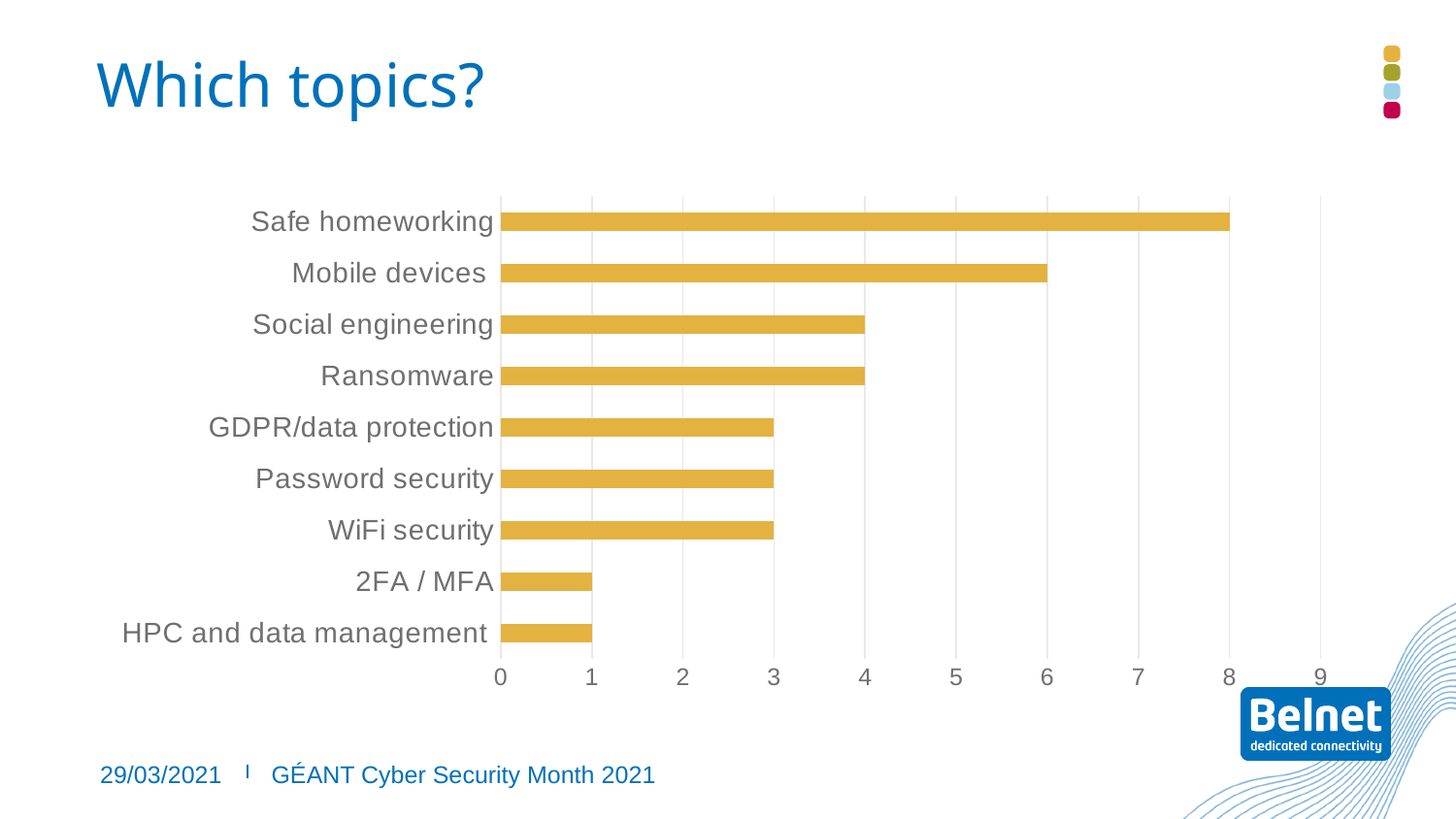
What is the difference between the values for Safe homeworking and Mobile devices? 2 What is the difference between the values for Password security and 2FA / MFA? 2 What is the value for Safe homeworking? 8 Which topic has the highest value? Safe homeworking What is the value for Ransomware? 4 Is the value for Mobile devices greater or less than 5? greater What is the value for WiFi security? 3 What is the value for Mobile devices? 6 Which is larger, the value for Social engineering or the value for GDPR/data protection? Social engineering What is the title of the slide containing the chart? Which topics? What kind of chart is shown on the slide? Bar chart How many topics are shown in the chart? 9